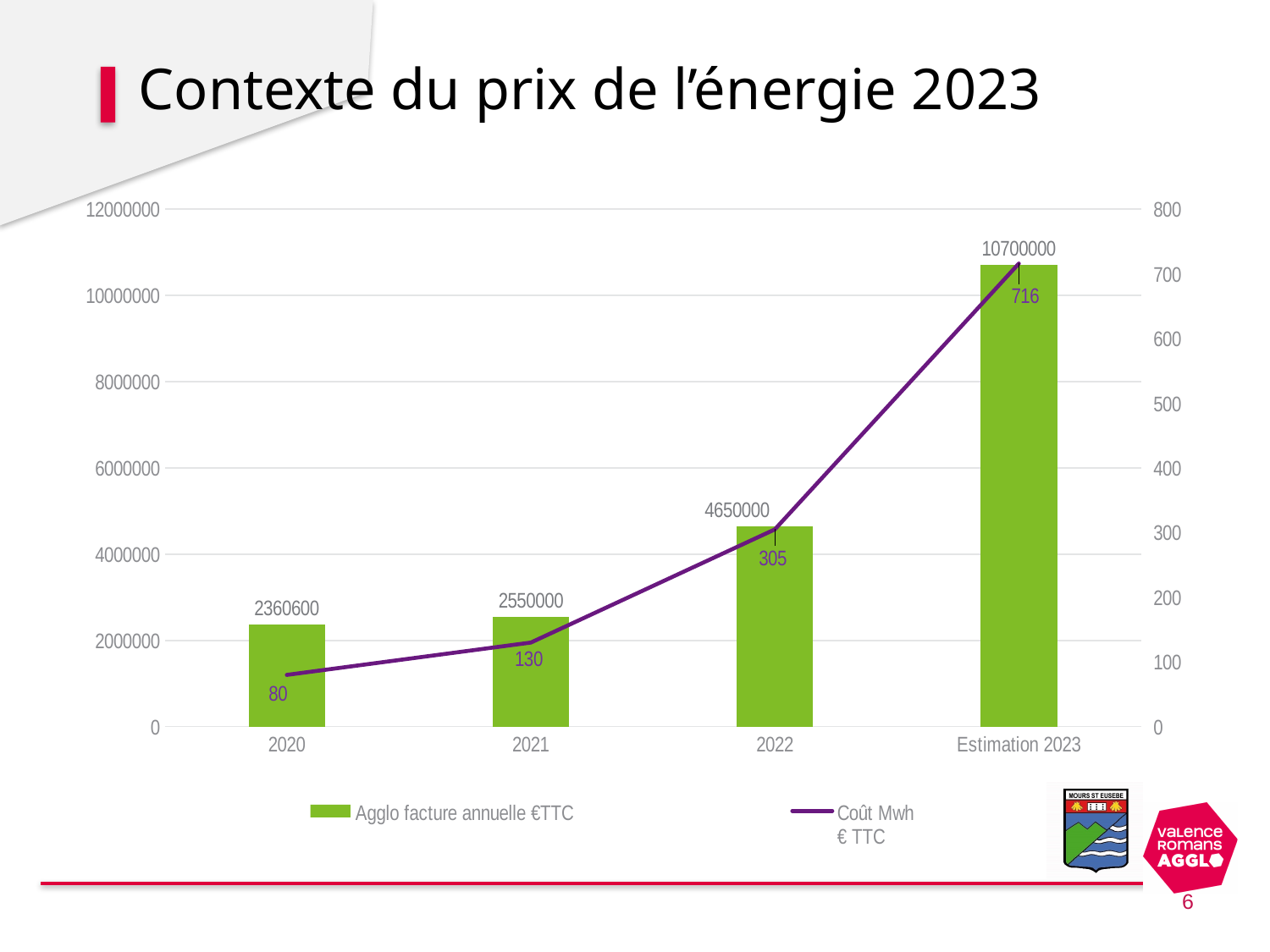
How many categories are shown on the x axis? 4 What is the difference between the 'Coût Mwh € TTC' values for 2022 and 2021? 175 Which category has the highest 'Agglo facture annuelle €TTC' value? Estimation 2023 What is the difference between the 'Agglo facture annuelle €TTC' values for Estimation 2023 and 2022? 6050000 Which category has the lowest 'Coût Mwh € TTC' value? 2020 How many series does the legend list? 2 Does the 'Coût Mwh € TTC' line rise or fall from 2020 to Estimation 2023? rise What is the value of 'Agglo facture annuelle €TTC' for 2022? 4650000 What is the 'Coût Mwh € TTC' value for 2021? 130 What is the value of 'Agglo facture annuelle €TTC' for 2020? 2360600 What is the 'Coût Mwh € TTC' value for Estimation 2023? 716 Which is larger, the 'Agglo facture annuelle €TTC' value for 2021 or for 2020? 2021